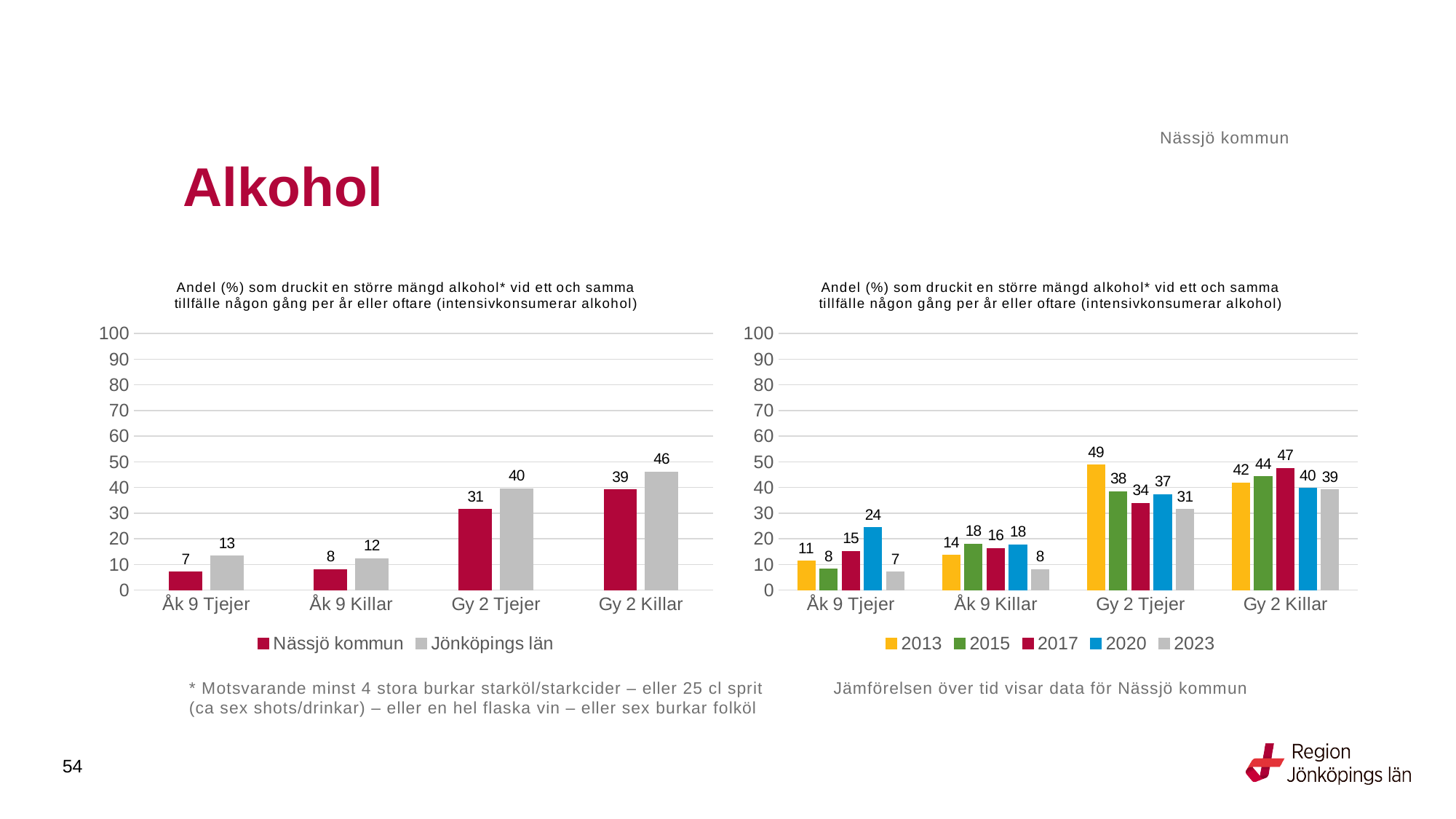
In the left chart, which category has the highest value for Nässjö kommun? Gy 2 Killar In the left chart, how many series does the legend list? 2 What kind of chart is the right chart? Bar chart In the right chart, which year has the lowest value for Åk 9 Killar? 2023 In the right chart, which is larger for Gy 2 Killar: 2017 or 2023? 2017 In the left chart, what is the difference between Jönköpings län and Nässjö kommun for Åk 9 Tjejer? 6 In the left chart, what is the value for Jönköpings län for Gy 2 Killar? 46 In the right chart, what is the difference between 2013 and 2023 for Gy 2 Tjejer? 18 In the right chart, what is the value for 2020 for Åk 9 Tjejer? 24 In the left chart, what is the value for Nässjö kommun for Gy 2 Tjejer? 31 In the right chart, what is the value for 2013 for Gy 2 Tjejer? 49 In the right chart, how many series does the legend list? 5